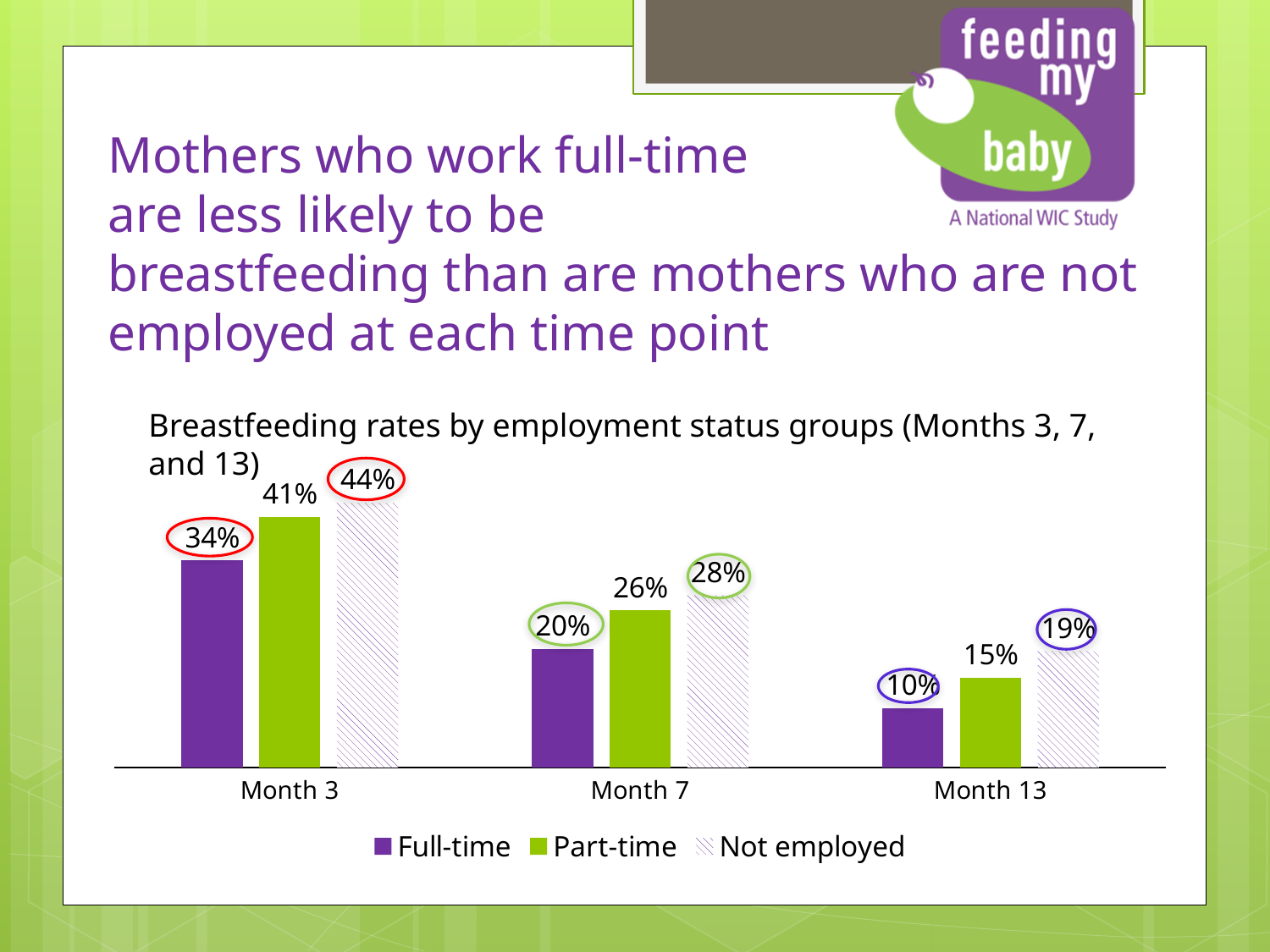
Which is larger: the Part-time rate at Month 3 or the Not employed rate at Month 7? Part-time rate at Month 3 Which employment status group has the highest breastfeeding rate at Month 3? Not employed Which employment status group has the lowest breastfeeding rate at Month 13? Full-time What is the breastfeeding rate for Part-time mothers at Month 7? 26% What kind of chart is shown on the slide? Bar chart What is the breastfeeding rate for Full-time mothers at Month 3? 34% Do the Full-time breastfeeding rates rise or fall from Month 3 to Month 13? Fall How many series does the legend list? 3 What is the title of the chart? Breastfeeding rates by employment status groups (Months 3, 7, and 13) What is the difference between the Not employed and Full-time breastfeeding rates at Month 7? 8% What is the breastfeeding rate for Not employed mothers at Month 13? 19% How many time points (categories) are shown on the x axis? 3